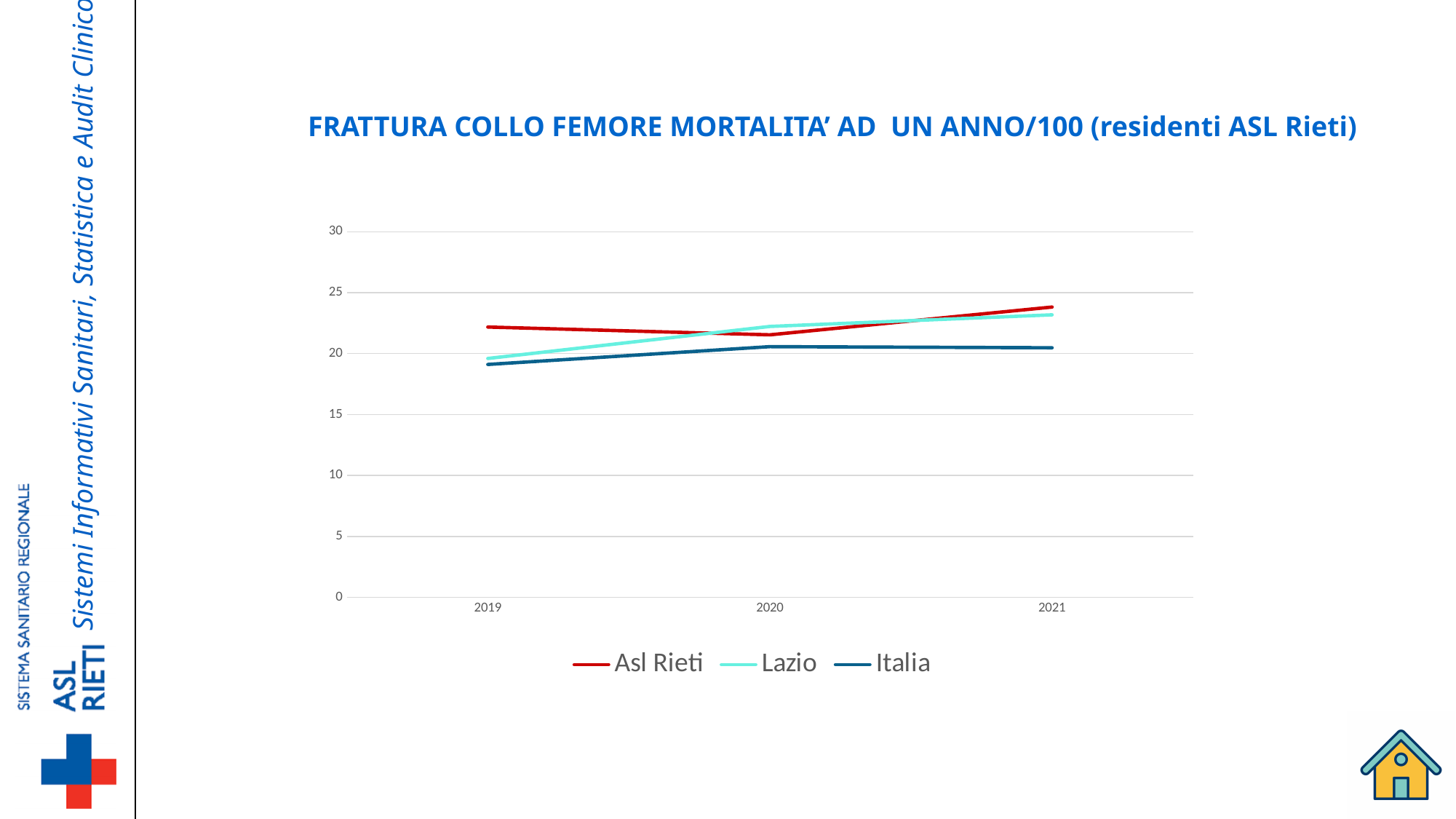
Which series has the lowest value in 2021? Italia In 2019, which is larger: the value for Asl Rieti or the value for Italia? Asl Rieti Is the value for Lazio in 2021 greater or less than 20? greater How many years are shown on the x axis? 3 Does the Lazio line rise or fall from 2019 to 2021? rise In 2021, which is larger: the value for Lazio or the value for Italia? Lazio Is the value for Asl Rieti in 2021 greater or less than 25? less Is the value for Italia in 2019 greater or less than 20? less What kind of chart is shown on the slide? line chart What is the title of the chart? FRATTURA COLLO FEMORE MORTALITA' AD UN ANNO/100 (residenti ASL Rieti) How many series does the legend list? 3